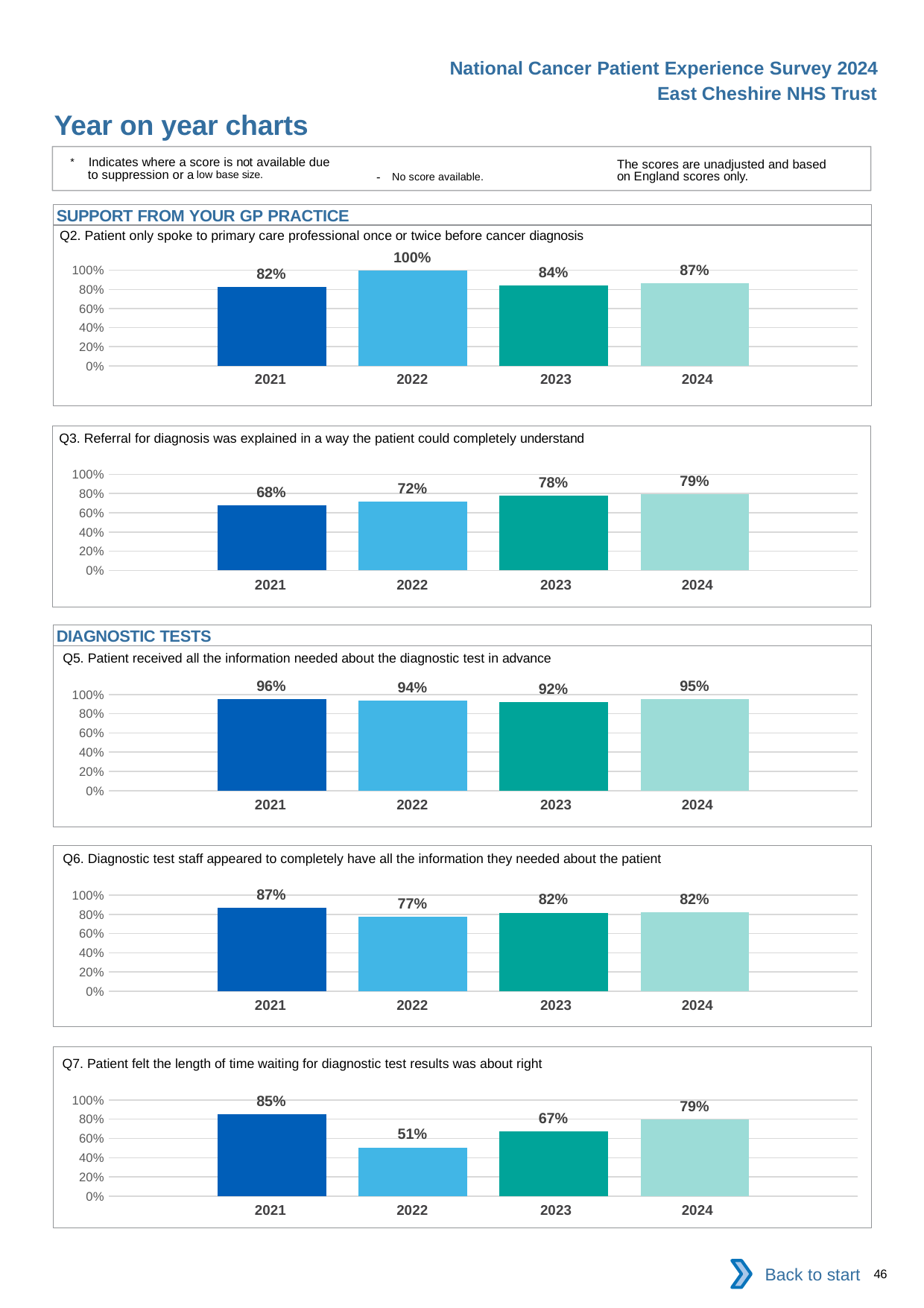
How many years are shown in the Q2 chart? 4 In the Q3 chart, which year has the lowest value? 2021 In the Q5 chart, what is the value for 2023? 92% In the Q2 chart, what is the value for 2022? 100% In the Q3 chart, do the values rise or fall from 2021 to 2024? rise In the Q6 chart, what is the difference between the 2021 and 2022 values? 10% What kind of chart is the Q7 chart? bar chart In the Q7 chart, what is the value for 2024? 79% In the Q3 chart, what is the difference between the 2024 and 2021 values? 11% In the Q7 chart, which year has the lowest value? 2022 In the Q5 chart, which year has the highest value? 2021 In the Q6 chart, which is larger, the value for 2021 or the value for 2022? 2021